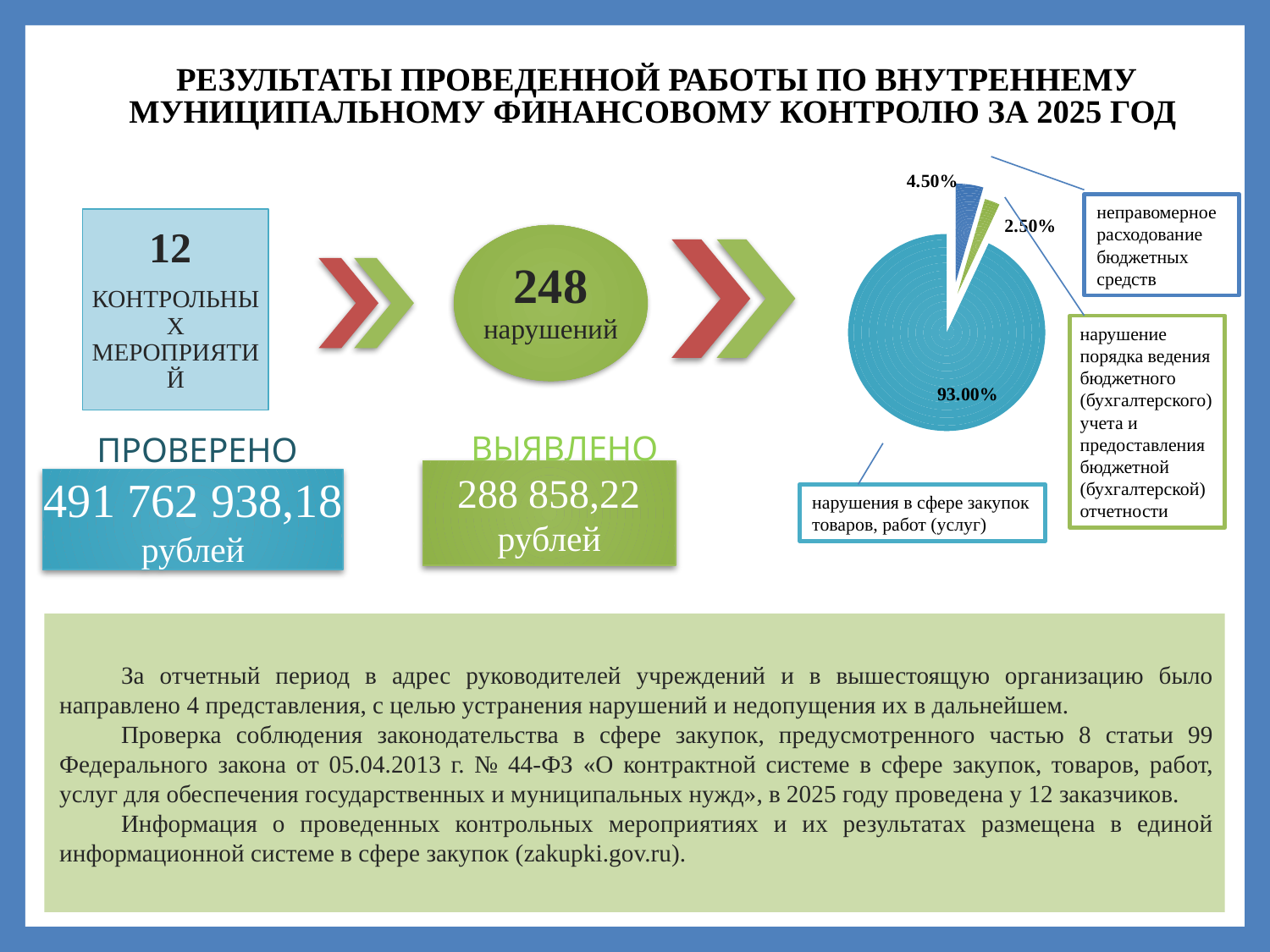
Which slice of the pie chart is the largest? нарушения в сфере закупок товаров, работ (услуг) What share of the pie is labelled 'неправомерное расходование бюджетных средств'? 4.50% What share of the pie is labelled 'нарушения в сфере закупок товаров, работ (услуг)'? 93.00% What is the difference in percentage points between the 'неправомерное расходование бюджетных средств' slice and the 'нарушение порядка ведения бюджетного (бухгалтерского) учета' slice? 2 percentage points How many slices does the pie chart have? 3 What is the difference in percentage points between the largest slice (93.00%) and the 4.50% slice? 88.5 percentage points What share of the pie is labelled 'нарушение порядка ведения бюджетного (бухгалтерского) учета и предоставления бюджетной (бухгалтерской) отчетности'? 2.50% What colour is the 2.50% slice of the pie chart? green Which slice of the pie chart is the smallest? нарушение порядка ведения бюджетного (бухгалтерского) учета и предоставления бюджетной (бухгалтерской) отчетности What colour is the largest slice of the pie chart? teal (blue-green) What kind of chart is shown on the slide? pie chart Which is larger: the share for 'неправомерное расходование бюджетных средств' or the share for 'нарушение порядка ведения бюджетного (бухгалтерского) учета'? неправомерное расходование бюджетных средств